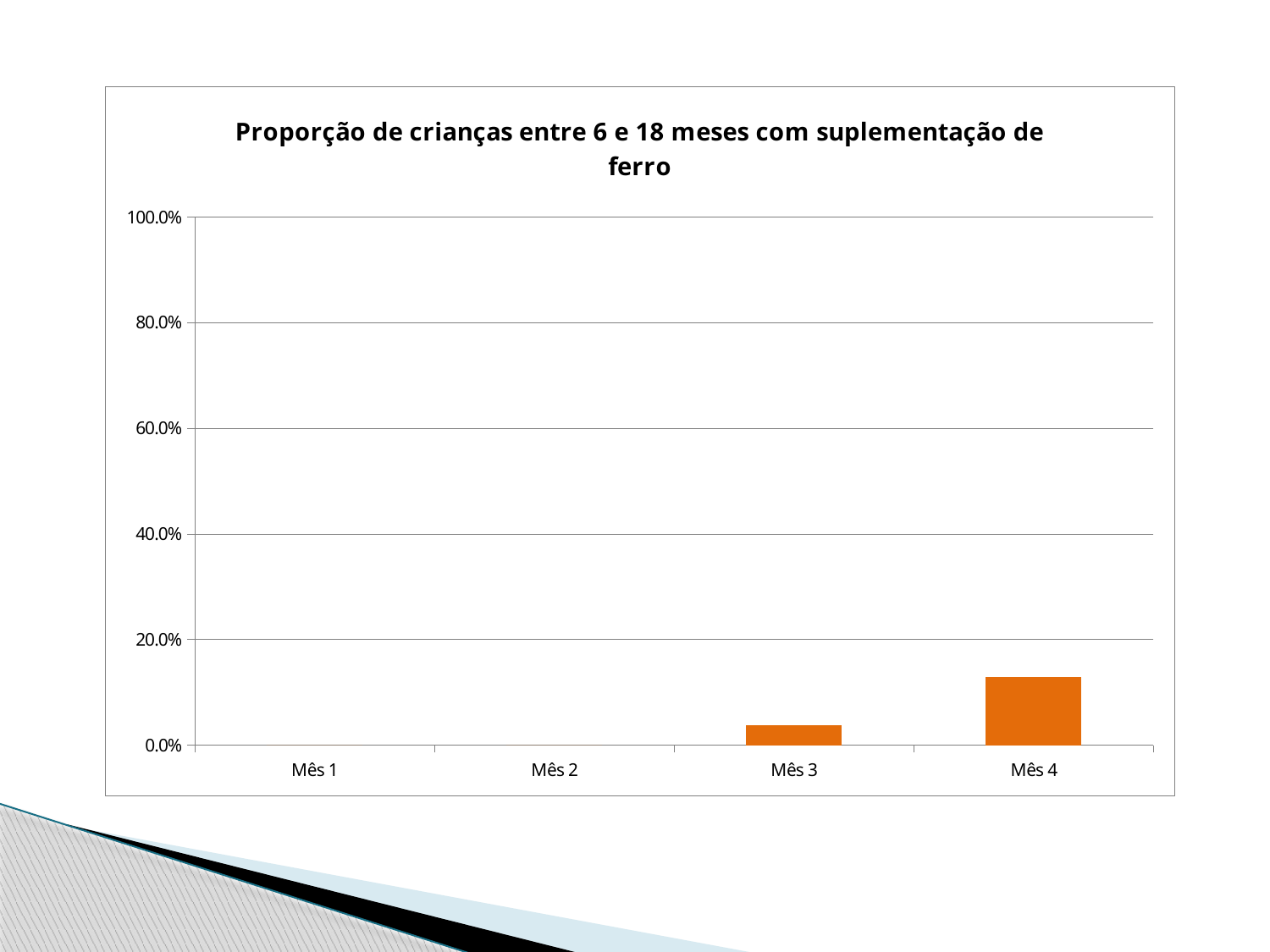
Which is larger, the value for Mês 3 or the value for Mês 4? Mês 4 Which of the two, Mês 2 or Mês 4, has the larger value? Mês 4 What is the title of the chart? Proporção de crianças entre 6 e 18 meses com suplementação de ferro What kind of chart is shown on the slide? bar chart Is the value for Mês 3 greater or less than 20.0%? less How many categories are shown on the x axis of the chart? 4 Is the value for Mês 4 greater or less than 40.0%? less What is the highest value shown on the y axis of the chart? 100.0% Do the values rise or fall from Mês 1 to Mês 4? rise Is the value for Mês 4 greater or less than 20.0%? less Which month has the highest proportion in the chart? Mês 4